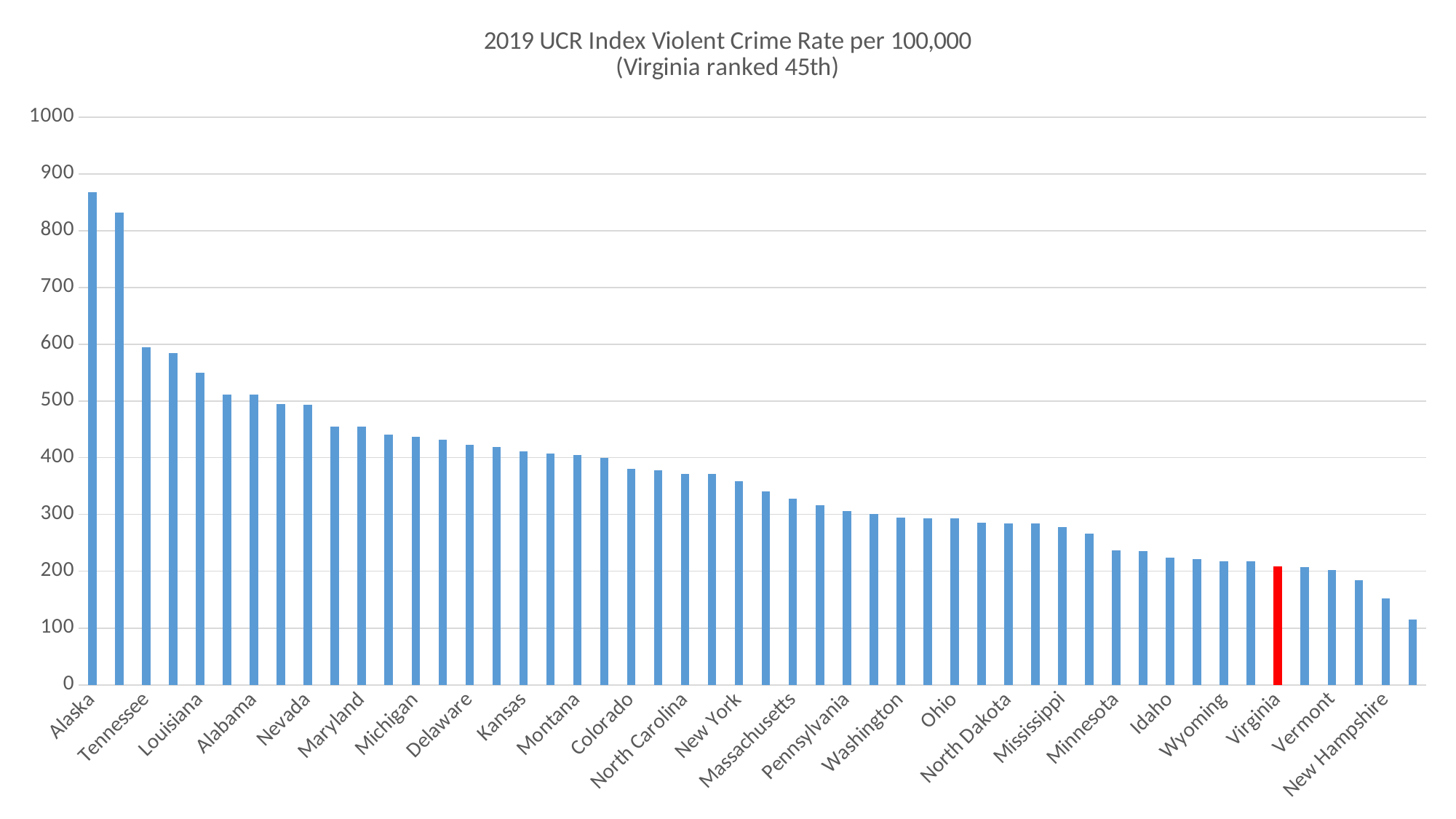
What kind of chart is shown on the slide? bar chart Which has the larger value, Virginia or New Hampshire? Virginia Is the value for North Carolina greater or less than 400? less Is the value for Alaska greater or less than 800? greater Which state has the highest violent crime rate in the chart? Alaska Which state's bar is coloured red? Virginia Is the value for New Hampshire greater or less than 200? less Do the values rise or fall moving from left to right along the x axis? fall Which has the larger value, Louisiana or Alabama? Louisiana